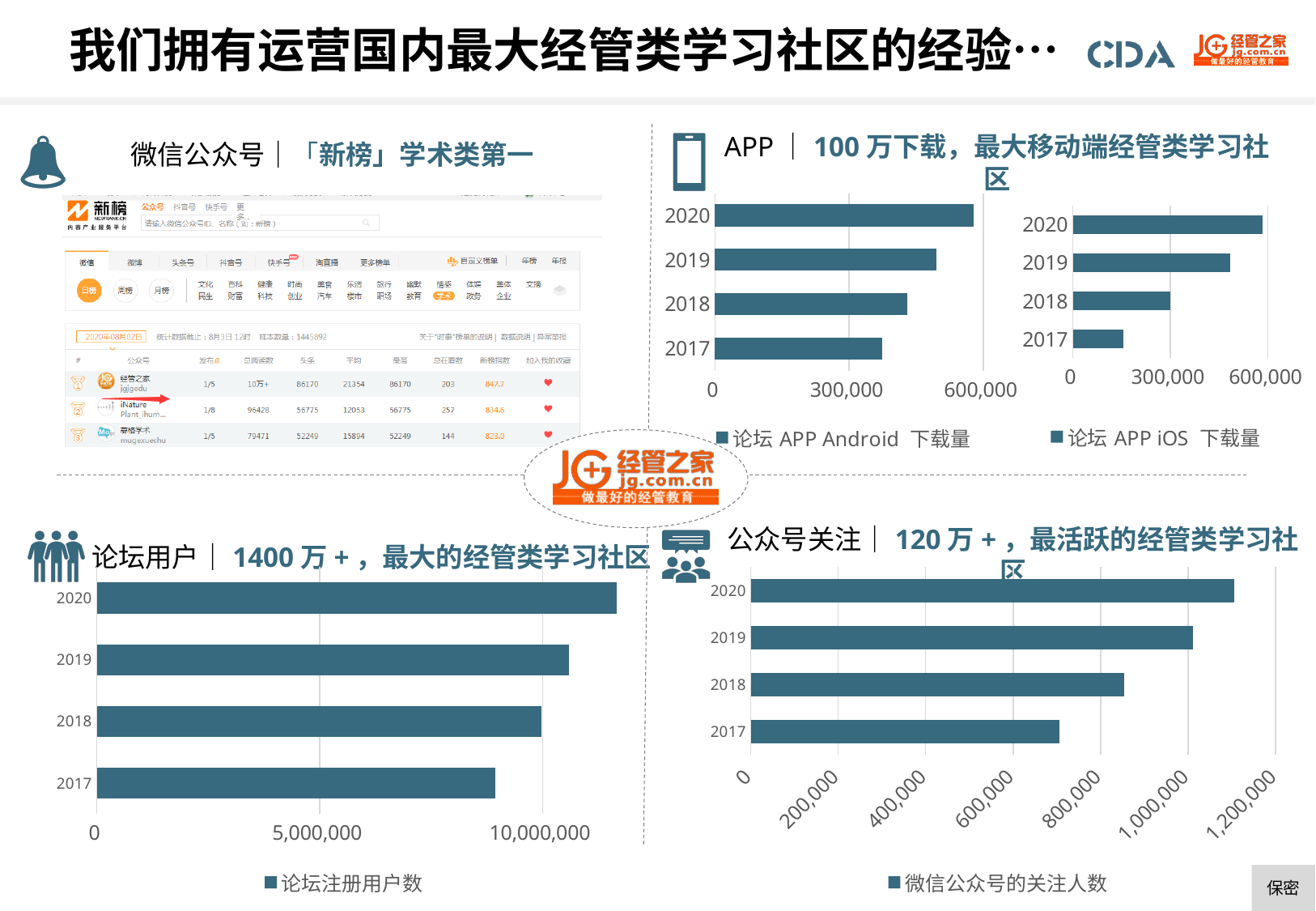
In the 论坛注册用户数 chart, do the values rise or fall from 2017 to 2020? rise In the 论坛 APP Android 下载量 chart, which year has the highest value? 2020 In the 微信公众号的关注人数 chart, is the value for 2017 greater or less than 800,000? less In the 论坛注册用户数 chart, is the value for 2020 greater or less than 10,000,000? greater In the 论坛 APP iOS 下载量 chart, which year has the lowest value? 2017 In the 论坛 APP iOS 下载量 chart, is the value for 2017 greater or less than 300,000? less How many years are shown in the 论坛注册用户数 chart? 4 What kind of chart is the 微信公众号的关注人数 chart? bar chart In the 论坛 APP iOS 下载量 chart, which is larger, the value for 2018 or the value for 2017? 2018